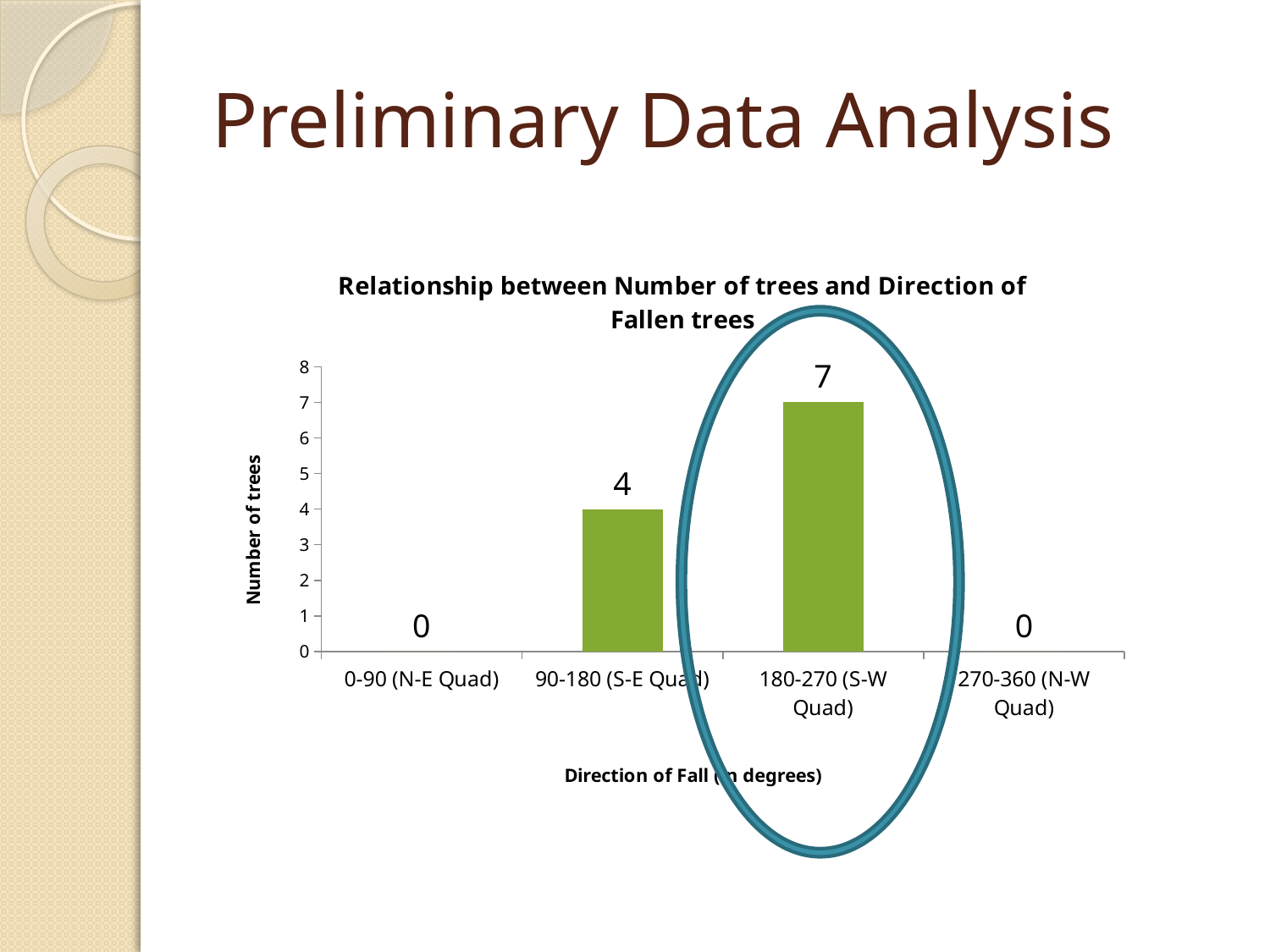
Is the value for 180-270 (S-W Quad) greater or less than 5? greater Which direction of fall has the highest number of trees? 180-270 (S-W Quad) What is the number of trees for the 0-90 (N-E Quad) direction? 0 What is the title of the chart? Relationship between Number of trees and Direction of Fallen trees What is the difference in number of trees between the 180-270 (S-W Quad) and 90-180 (S-E Quad) directions? 3 What is the number of trees for the 180-270 (S-W Quad) direction? 7 What is the number of trees for the 90-180 (S-E Quad) direction? 4 What kind of chart is shown on the slide? bar chart Which has more trees, 90-180 (S-E Quad) or 180-270 (S-W Quad)? 180-270 (S-W Quad) What is the total number of trees across all four directions? 11 How many direction categories are shown on the x axis? 4 What is the label of the y axis? Number of trees